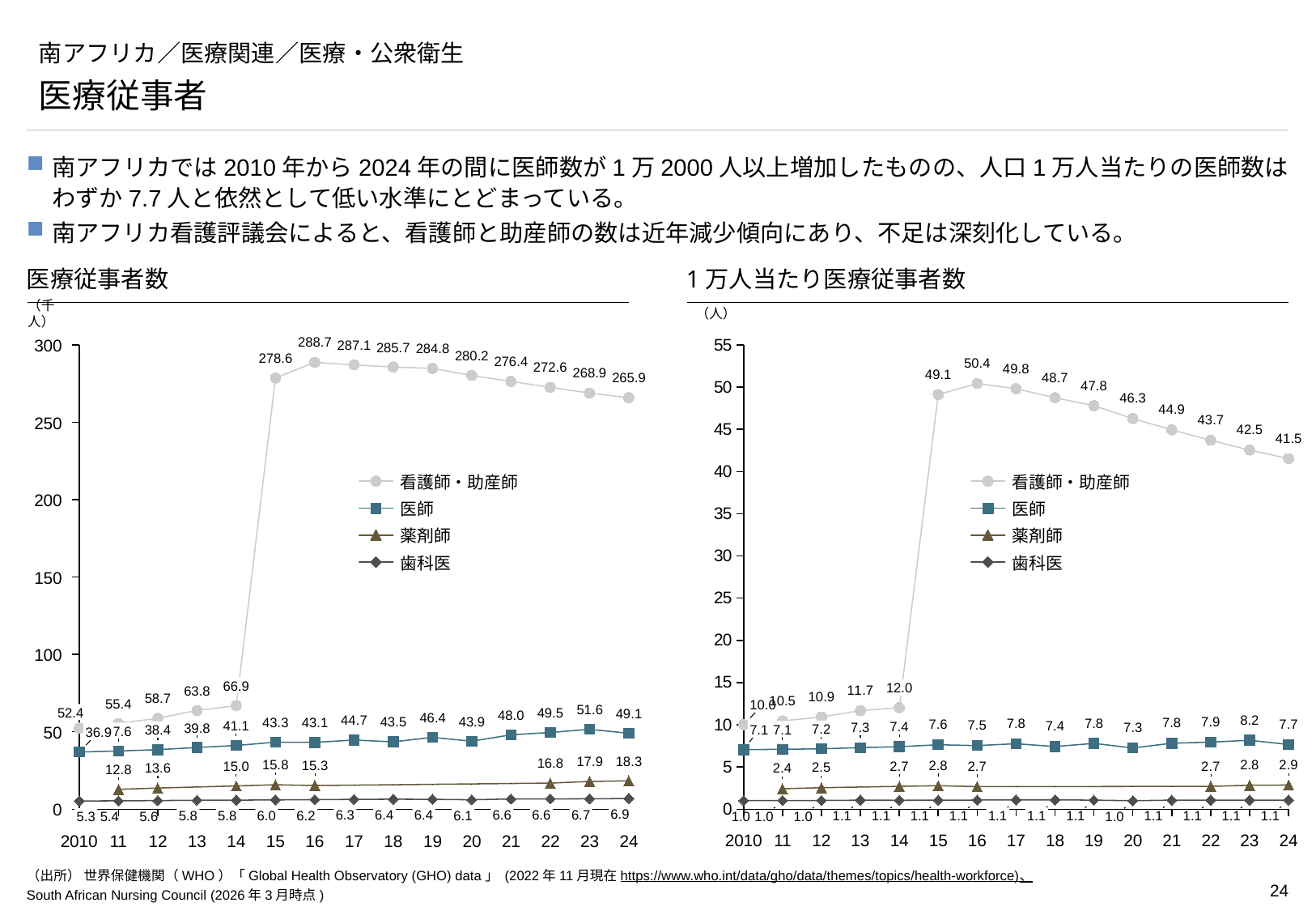
「1万人当たり医療従事者数」のグラフで、2016年から2024年にかけて看護師・助産師の値は上昇していますか、下降していますか？ 下降 「1万人当たり医療従事者数」のグラフで、2024年の医師の値はいくつですか？ 7.7 「医療従事者数」のグラフで、2023年の医師と2024年の医師の値の差はいくつですか？ 2.5 「1万人当たり医療従事者数」のグラフで、看護師・助産師の値が最も高いのは何年ですか？ 2016年 「医療従事者数」のグラフで、2010年から2014年にかけて歯科医の値は上昇していますか、下降していますか？ 上昇 「1万人当たり医療従事者数」のグラフはどの種類のグラフですか？ 折れ線グラフ 「1万人当たり医療従事者数」のグラフで、2016年の看護師・助産師の値は50より大きいですか、小さいですか？ 大きい 「1万人当たり医療従事者数」のグラフで、2023年の医師と2024年の医師ではどちらの値が大きいですか？ 2023年 「医療従事者数」のグラフで、2016年の看護師・助産師の値はいくつですか？ 288.7 「医療従事者数」のグラフで、2024年の医師の値はいくつですか？ 49.1 「医療従事者数」のグラフの凡例には何系列ありますか？ 4 「医療従事者数」のグラフで、看護師・助産師の値が最も高いのは何年ですか？ 2016年